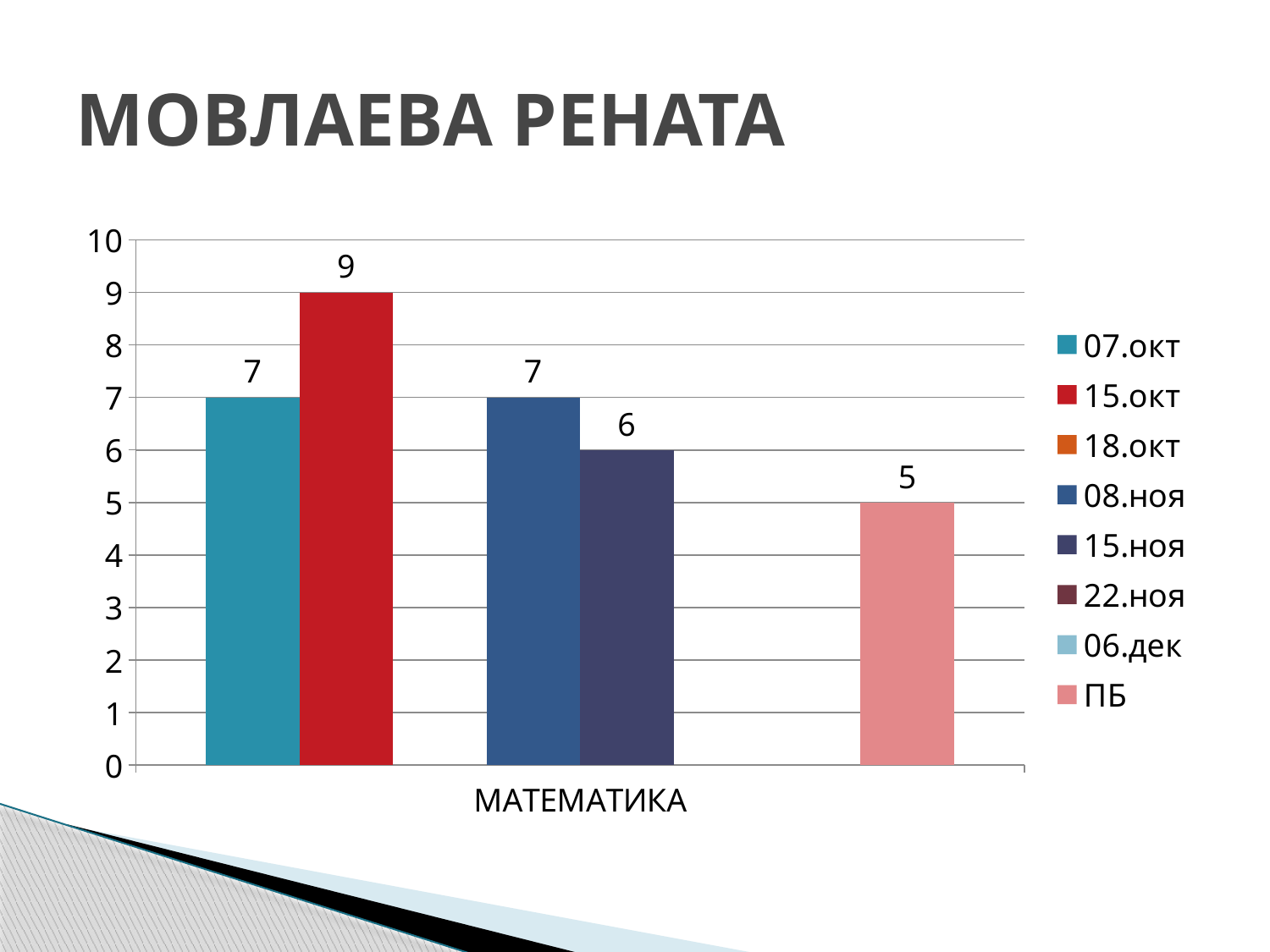
How many categories are shown on the x axis? 1 Which is larger, the value for 08.ноя or the value for 15.ноя? 08.ноя What is the title of the slide? МОВЛАЕВА РЕНАТА What is the difference between the values for 15.окт and ПБ? 4 Which series has the lowest plotted value in МАТЕМАТИКА? ПБ How many series does the legend list? 8 Which series has the highest value in МАТЕМАТИКА? 15.окт What is the value for 15.ноя in МАТЕМАТИКА? 6 What is the value for 07.окт in МАТЕМАТИКА? 7 What is the value for 15.окт in МАТЕМАТИКА? 9 What is the value for ПБ in МАТЕМАТИКА? 5 What kind of chart is shown on the slide? bar chart